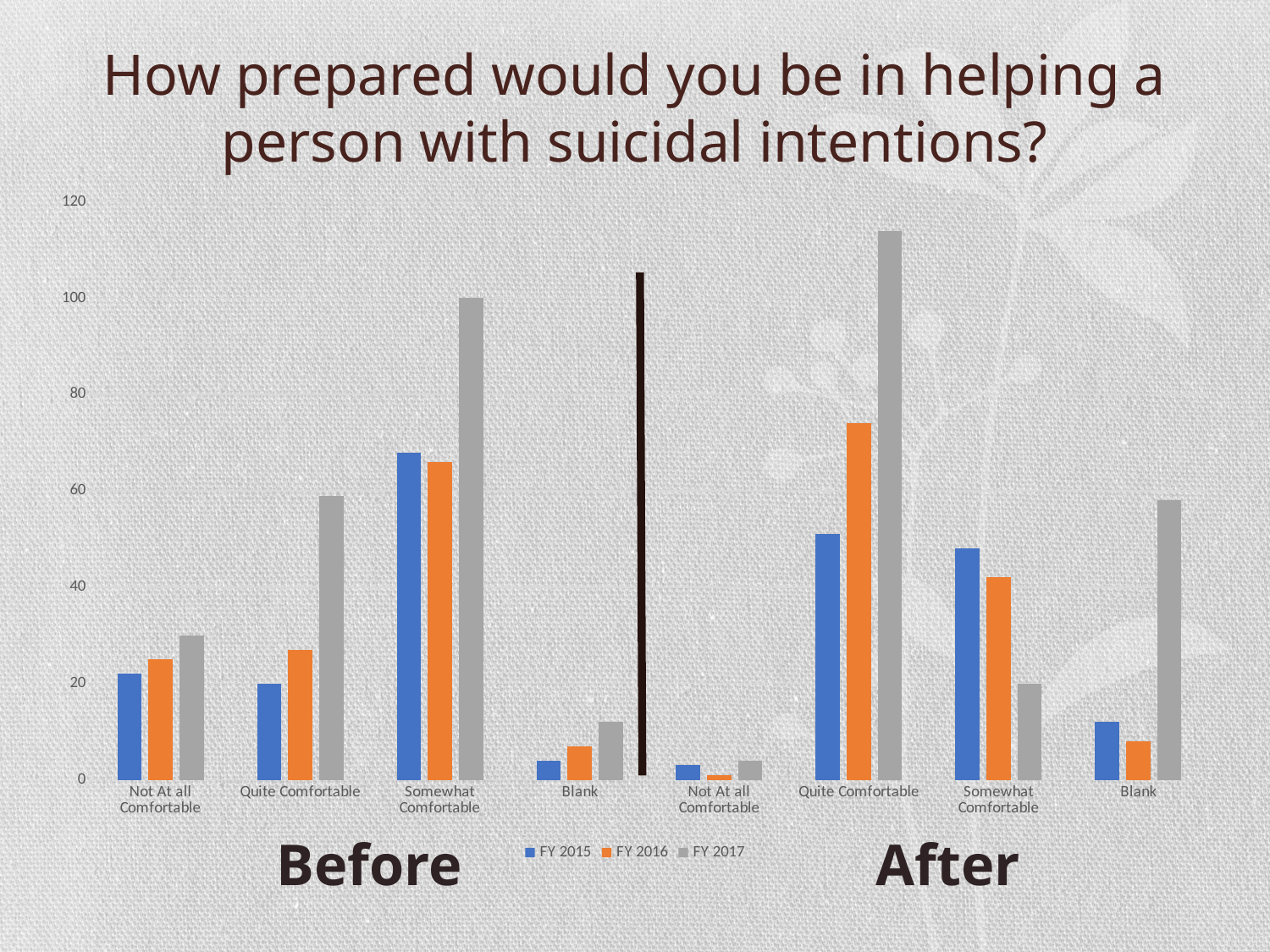
Which series has the lowest bar for 'Somewhat Comfortable' in the After section? FY 2017 In the Before section, which is larger for 'Quite Comfortable': FY 2015 or FY 2017? FY 2017 Which series has the highest bar for 'Quite Comfortable' in the After section? FY 2017 Is the FY 2017 value for 'Somewhat Comfortable' in the Before section greater or less than 80? greater In the After section, which is larger for 'Somewhat Comfortable': FY 2015 or FY 2016? FY 2015 What kind of chart is shown on the slide? bar chart What are the three entries in the chart's legend? FY 2015, FY 2016, FY 2017 How many categories are shown along the x axis of the chart? 8 Is the FY 2017 value for 'Quite Comfortable' in the After section greater or less than 100? greater How many series does the legend list? 3 Is the FY 2017 value for 'Blank' in the After section greater or less than 40? greater